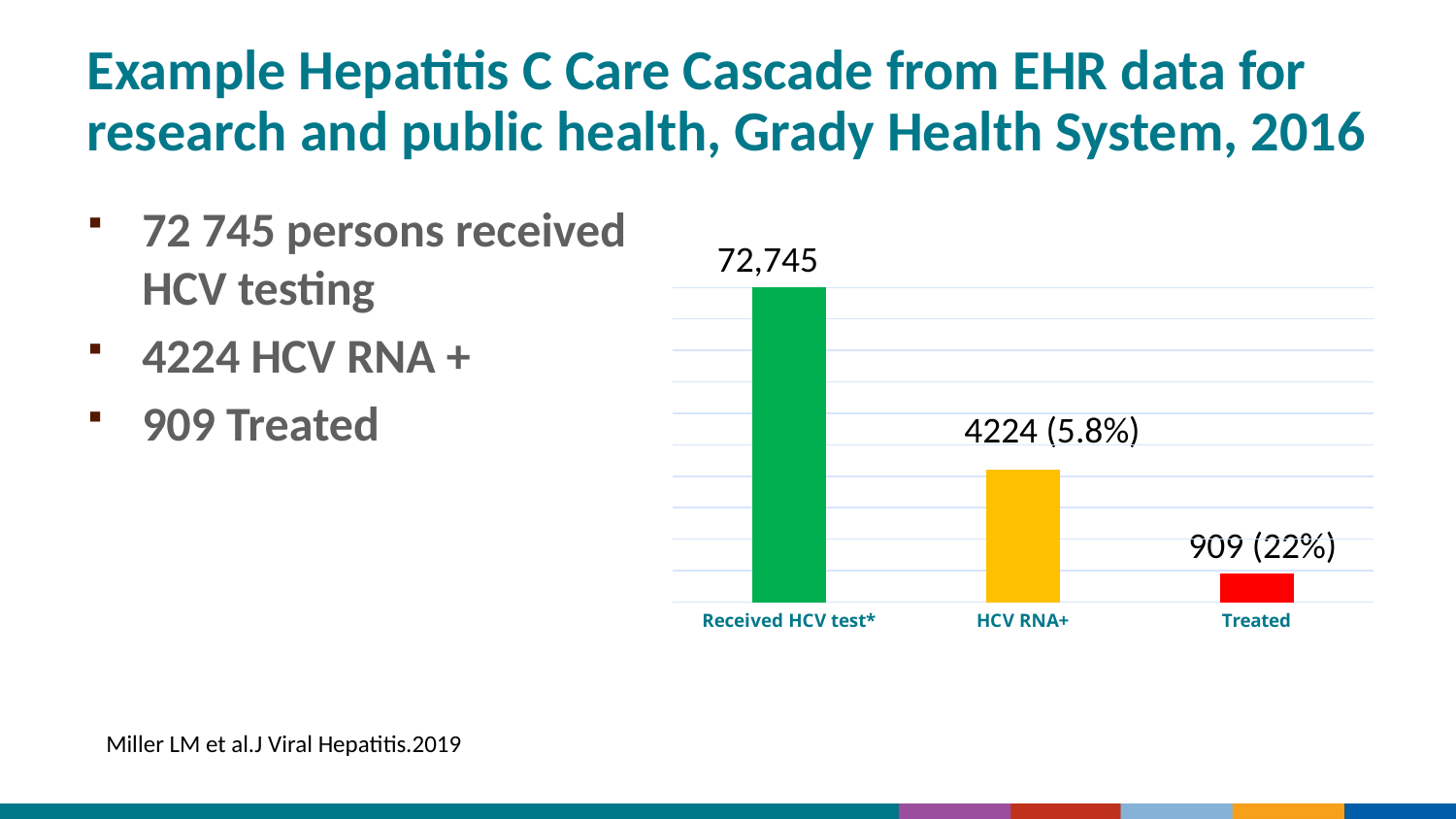
What colour is the bar for Treated? Red What is the value for Received HCV test*? 72,745 What is the data label shown for HCV RNA+? 4224 (5.8%) Which category has the highest value? Received HCV test* Which is larger, the value for HCV RNA+ or the value for Treated? HCV RNA+ How many categories are shown on the chart? 3 Do the values rise or fall from left to right across the categories? Fall What is the difference between the HCV RNA+ value and the Treated value? 3,315 What is the difference between the Received HCV test* value and the HCV RNA+ value? 68,521 What is the data label shown for Treated? 909 (22%) Which category has the lowest value? Treated What kind of chart is shown on the slide? Bar chart